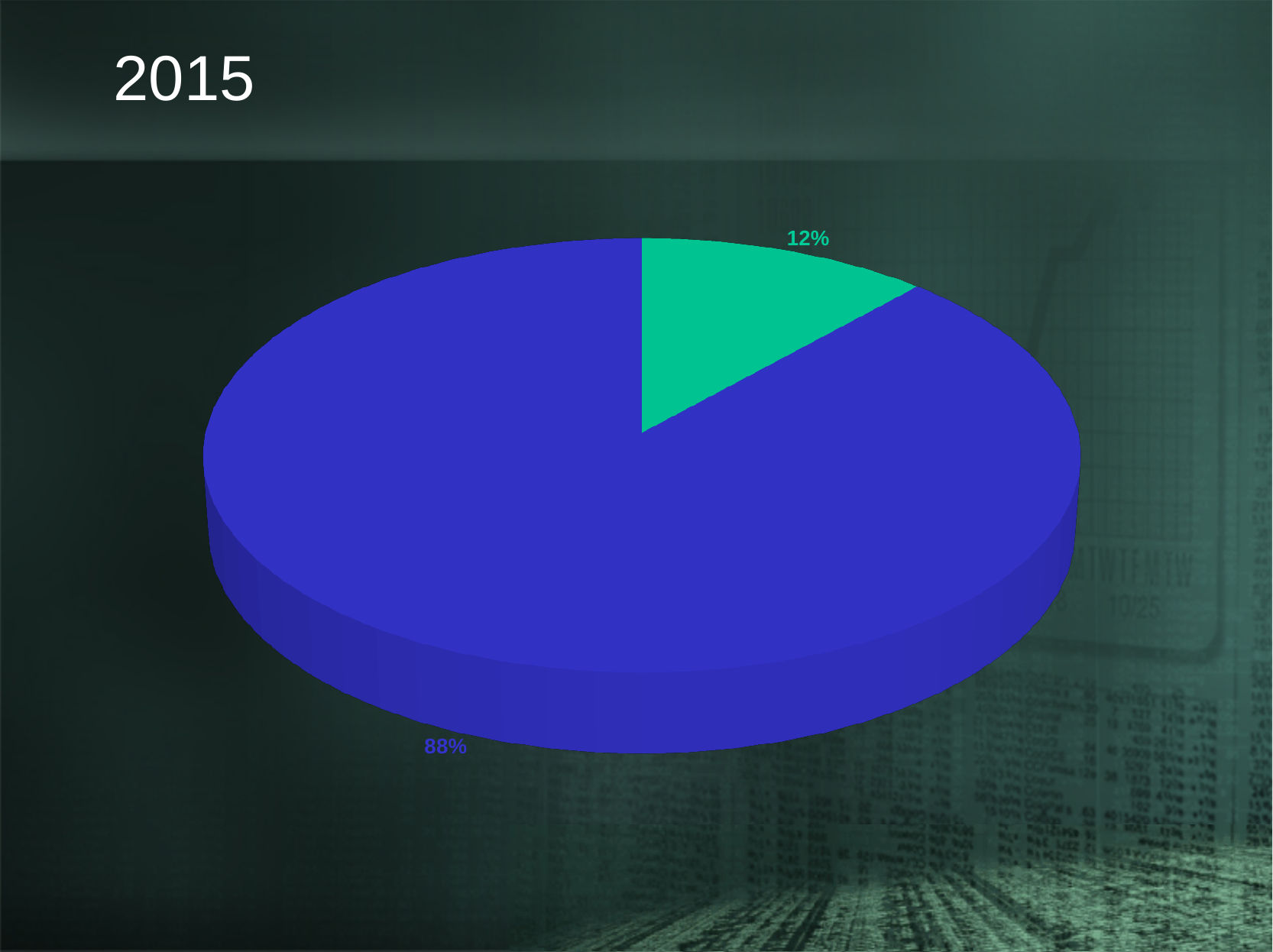
What is the difference in percentage points between the blue slice and the green slice? 76 How many slices does the pie chart have? 2 What percentage is shown for the green slice of the pie chart? 12% What kind of chart is shown on the slide? pie chart Which is larger, the blue slice or the green slice? the blue slice Which slice of the pie chart is the smallest? the green slice (12%) What colour is the slice labelled 88%? blue Which slice of the pie chart is the largest? the blue slice (88%) What share of the pie does the green slice represent? 12% What is the title shown above the pie chart? 2015 What percentage is shown for the blue slice of the pie chart? 88%